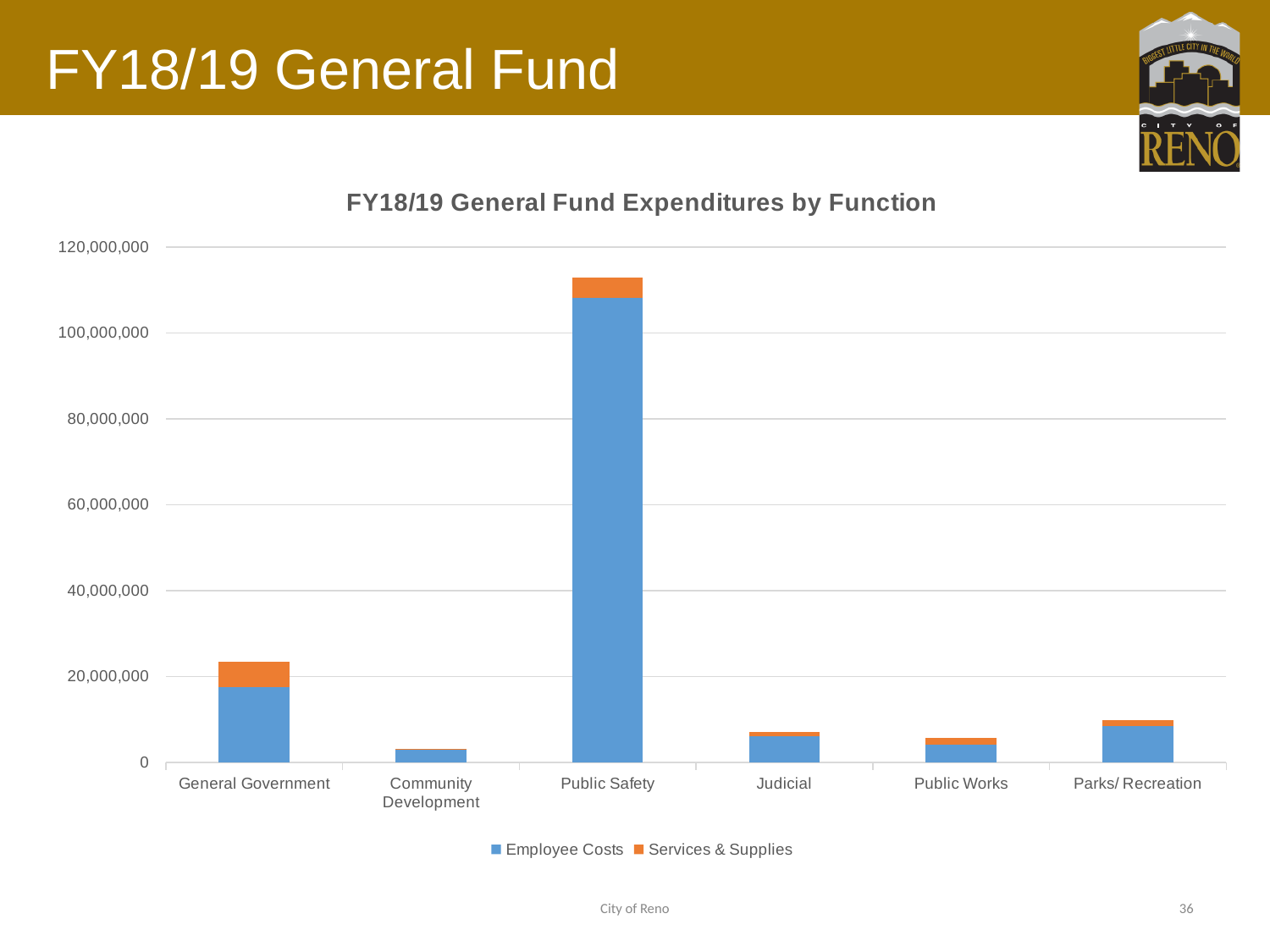
Which series is shown in orange in the chart? Services & Supplies Which has the larger total expenditure, General Government or Parks/Recreation? General Government What kind of chart is shown on the slide? Stacked bar chart Which function has the highest total expenditure in the chart? Public Safety How many functions (categories) are shown on the x axis of the chart? 6 Is the total expenditure for Public Safety greater or less than 100,000,000? greater What is the title of the chart? FY18/19 General Fund Expenditures by Function How many series does the chart's legend list? 2 Is the total expenditure for General Government greater or less than 20,000,000? greater Is the total expenditure for Judicial greater or less than 20,000,000? less Which has the larger total expenditure, Community Development or Public Works? Public Works Which function has the lowest total expenditure in the chart? Community Development